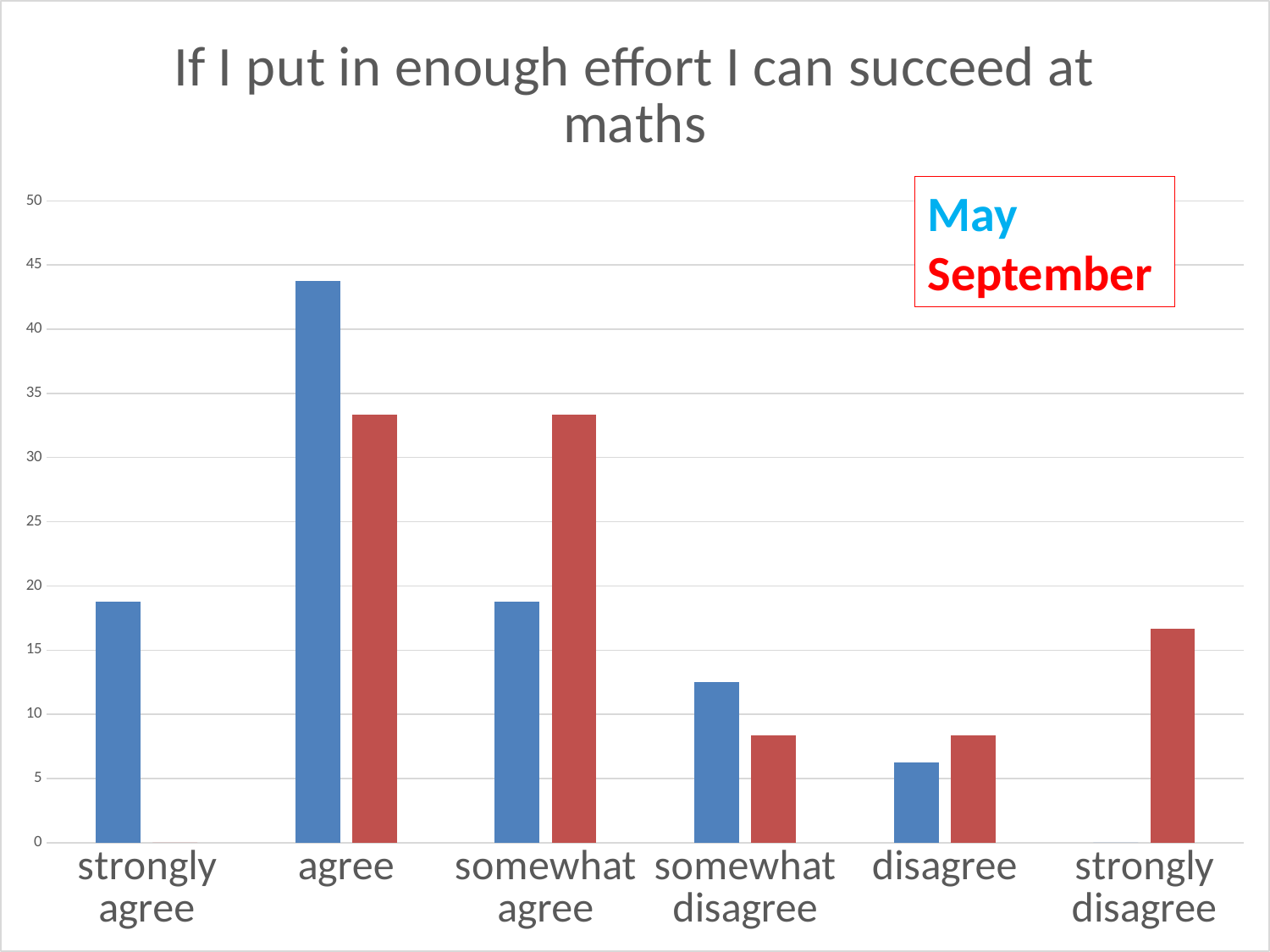
How many series does the legend list? 2 Which category has the lowest value for September? strongly agree For agree, which series has the larger value, May or September? May Is the September value for somewhat agree greater or less than 30? greater Which colour represents the September series? red How many response categories are shown on the x axis? 6 Is the May value for disagree greater or less than 10? less What kind of chart is shown on the slide? bar chart Which category has the lowest value for May? strongly disagree Is the May value for agree greater or less than 40? greater For somewhat agree, which series has the larger value, May or September? September Which category has the highest value for May? agree